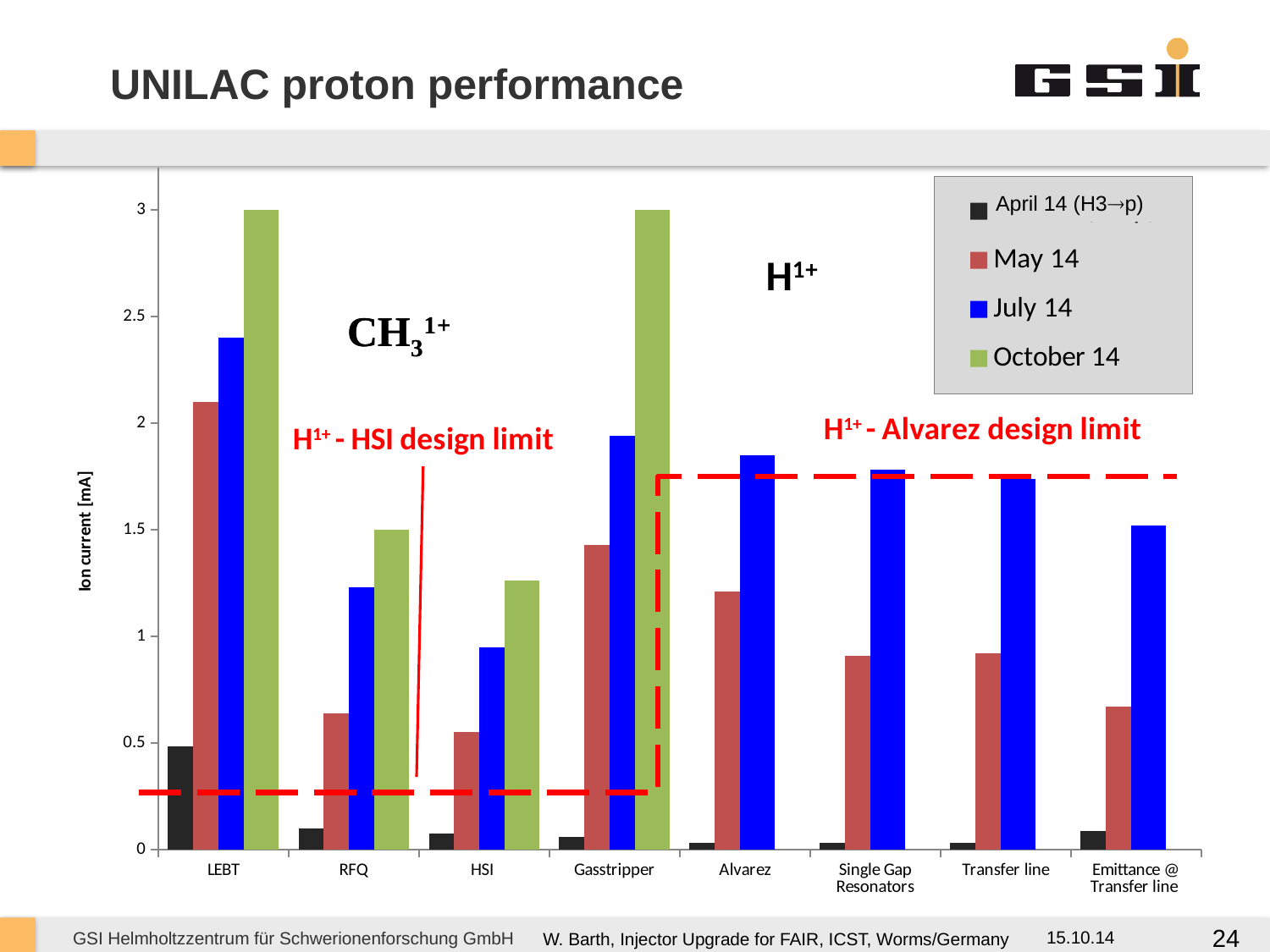
Is the October 14 value for HSI greater or less than 1? greater Which is larger, the April 14 value for LEBT or the April 14 value for Gasstripper? LEBT Is the May 14 value for Emittance @ Transfer line greater or less than 1? less What kind of chart is shown on the slide? bar chart Which category has the lowest July 14 bar? HSI Which is larger, the May 14 value for LEBT or the May 14 value for RFQ? LEBT Which category has the highest July 14 bar? LEBT What is the label of the y axis? Ion current [mA] How many series does the legend list? 4 How many categories are shown along the x axis? 8 Is the July 14 value for RFQ greater or less than 1.5? less